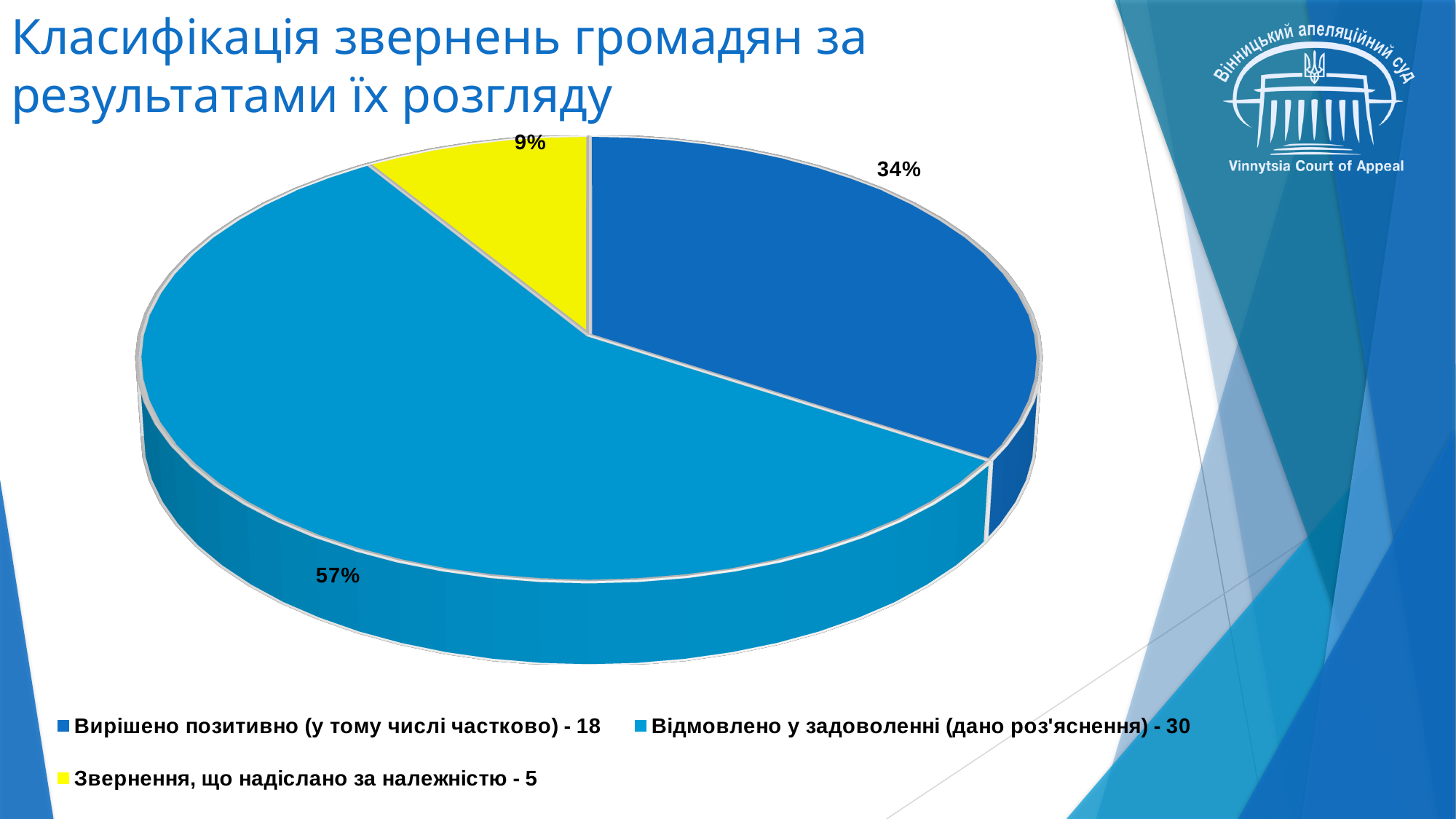
How many entries does the legend list? 3 Which is larger: the share for "Вирішено позитивно (у тому числі частково)" or the share for "Звернення, що надіслано за належністю"? Вирішено позитивно (у тому числі частково) Which category has the largest share of the pie? Відмовлено у задоволенні (дано роз'яснення) - 30 What percentage is shown for the slice "Вирішено позитивно (у тому числі частково) - 18"? 34% What kind of chart is shown on the slide? pie chart How many slices does the pie chart have? 3 What colour is the slice for "Звернення, що надіслано за належністю - 5"? yellow What percentage is shown for the slice "Відмовлено у задоволенні (дано роз'яснення) - 30"? 57% What is the difference in percentage points between the 57% slice and the 34% slice? 23 What percentage is shown for the slice "Звернення, що надіслано за належністю - 5"? 9% Which category has the smallest share of the pie? Звернення, що надіслано за належністю - 5 What share of the pie does the yellow slice represent? 9%